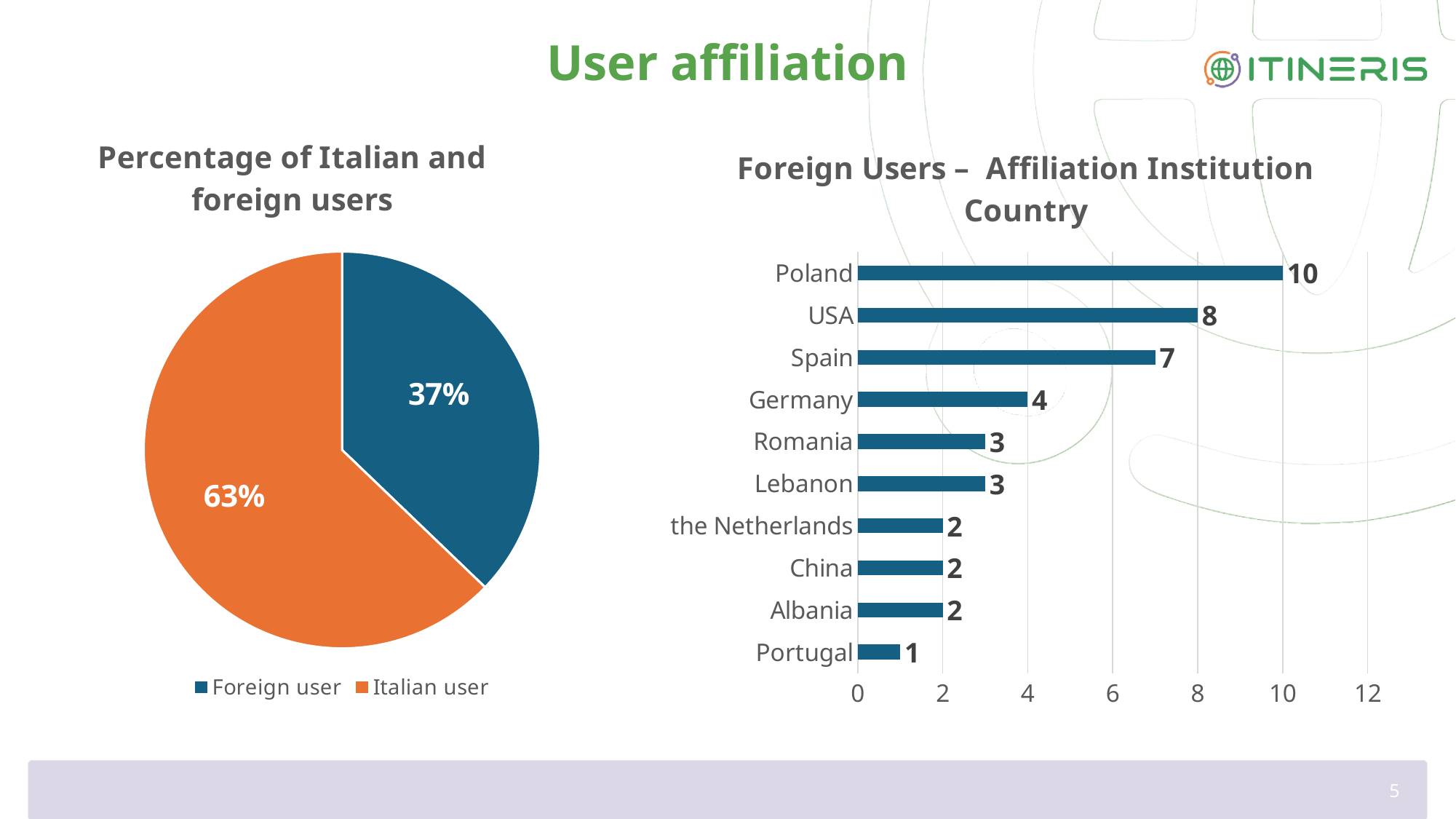
In the 'Foreign Users – Affiliation Institution Country' chart, which country has the lowest value? Portugal In the 'Percentage of Italian and foreign users' chart, what share of users are Italian users? 63% What kind of chart is the 'Percentage of Italian and foreign users' chart? pie chart In the 'Percentage of Italian and foreign users' chart, what share of users are Foreign users? 37% In the 'Foreign Users – Affiliation Institution Country' chart, which country has the highest value? Poland In the 'Percentage of Italian and foreign users' chart, how many entries does the legend list? 2 What kind of chart is the 'Foreign Users – Affiliation Institution Country' chart? bar chart How many countries are shown in the 'Foreign Users – Affiliation Institution Country' chart? 10 In the 'Foreign Users – Affiliation Institution Country' chart, what is the value for Spain? 7 In the 'Foreign Users – Affiliation Institution Country' chart, what is the difference between the values for Poland and USA? 2 In the 'Foreign Users – Affiliation Institution Country' chart, which has a larger value, Romania or Albania? Romania In the 'Foreign Users – Affiliation Institution Country' chart, what is the value for Germany? 4